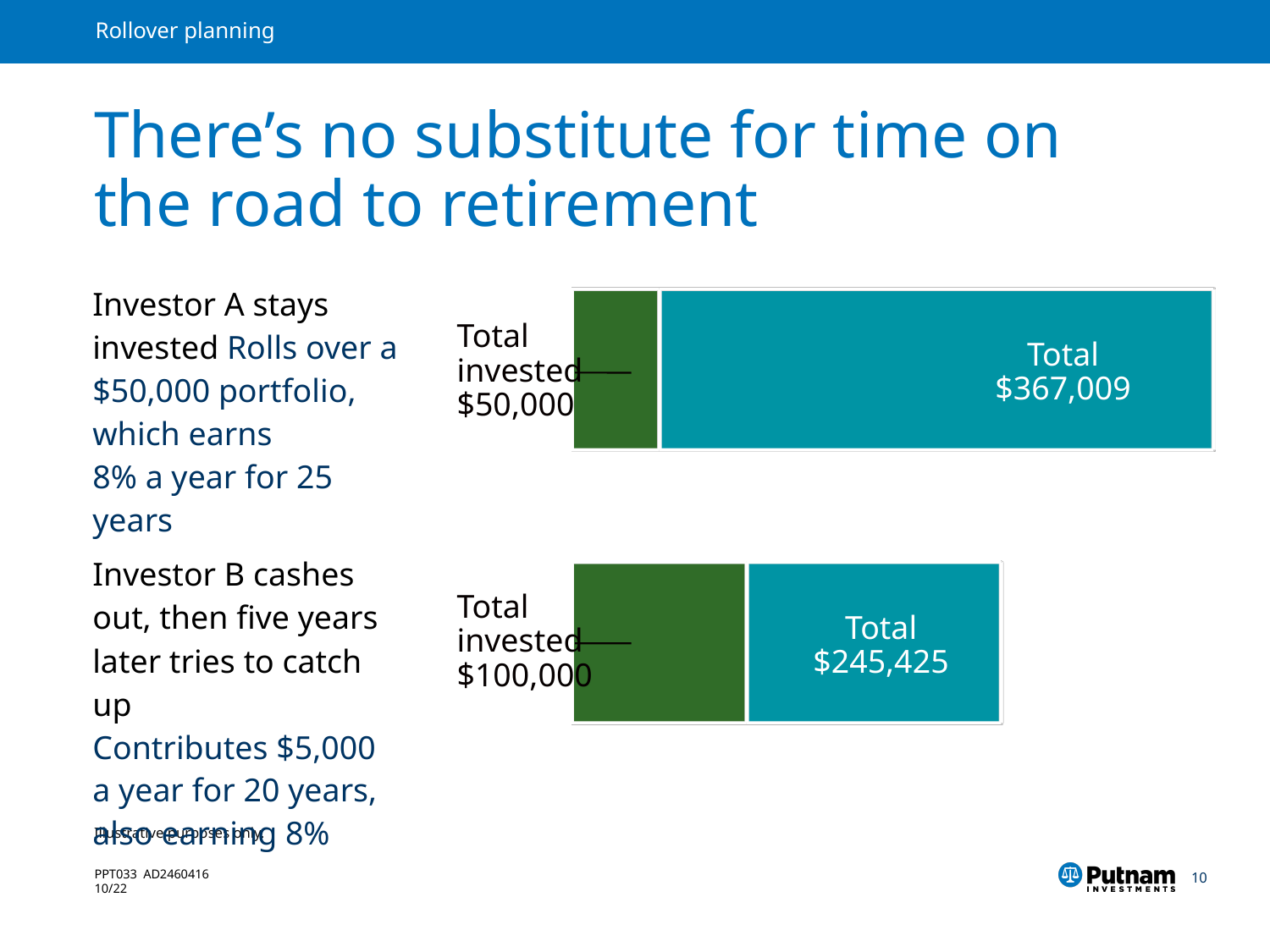
What is the difference between the total for Investor A ($367,009) and the total for Investor B ($245,425)? $121,584 What is the difference between the total invested by Investor B and the total invested by Investor A? $50,000 Which investor's chart shows the larger total, Investor A (top) or Investor B (bottom)? Investor A In the top chart, what colour is the segment representing the total invested? Green In the top chart (Investor A), what is the total invested amount shown? $50,000 In the top chart (Investor A), what total value is labeled on the bar? $367,009 In the bottom chart (Investor B), what is the total invested amount shown? $100,000 What kind of chart is used to show each investor's results? Bar chart How many bar charts are shown on the slide? 2 In the bottom chart, what colour is the segment labeled with the total of $245,425? Teal In the bottom chart (Investor B), what total value is labeled on the bar? $245,425 Which investor's chart shows the larger total invested amount, Investor A (top) or Investor B (bottom)? Investor B